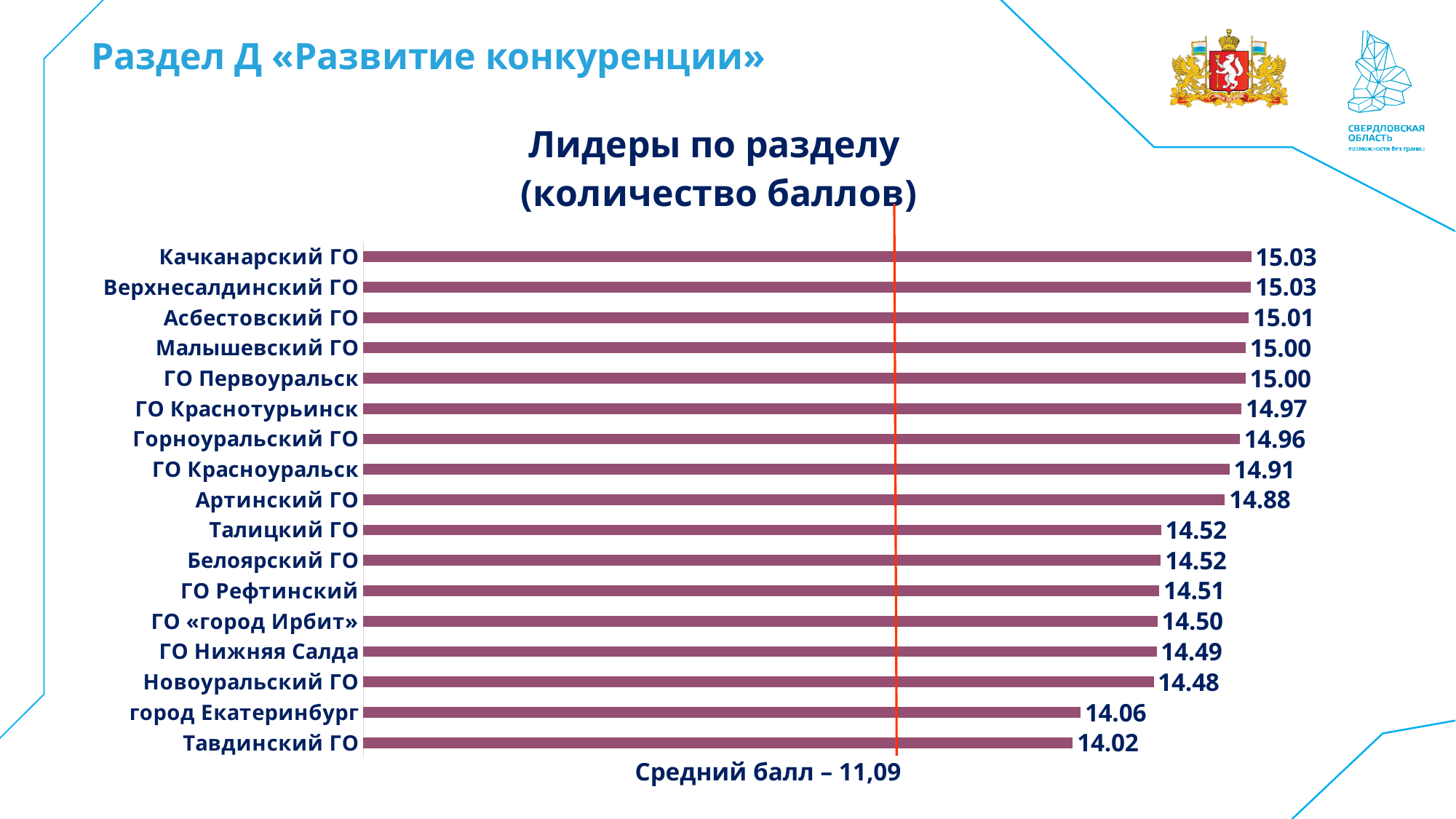
What is the value for Тавдинский ГО? 14.02 Which is larger, the value for Горноуральский ГО or the value for Новоуральский ГО? Горноуральский ГО How many categories are shown in the chart? 17 What average score is marked by the vertical line on the chart? 11,09 What is the title of the chart? Лидеры по разделу (количество баллов) What is the value for город Екатеринбург? 14.06 What type of chart is shown on the slide? bar chart What is the value for ГО Краснотурьинск? 14.97 What is the difference between the values for Артинский ГО and Талицкий ГО? 0.36 What is the value for ГО «город Ирбит»? 14.50 Which category has the lowest value? Тавдинский ГО What is the difference between the values for Качканарский ГО and Тавдинский ГО? 1.01